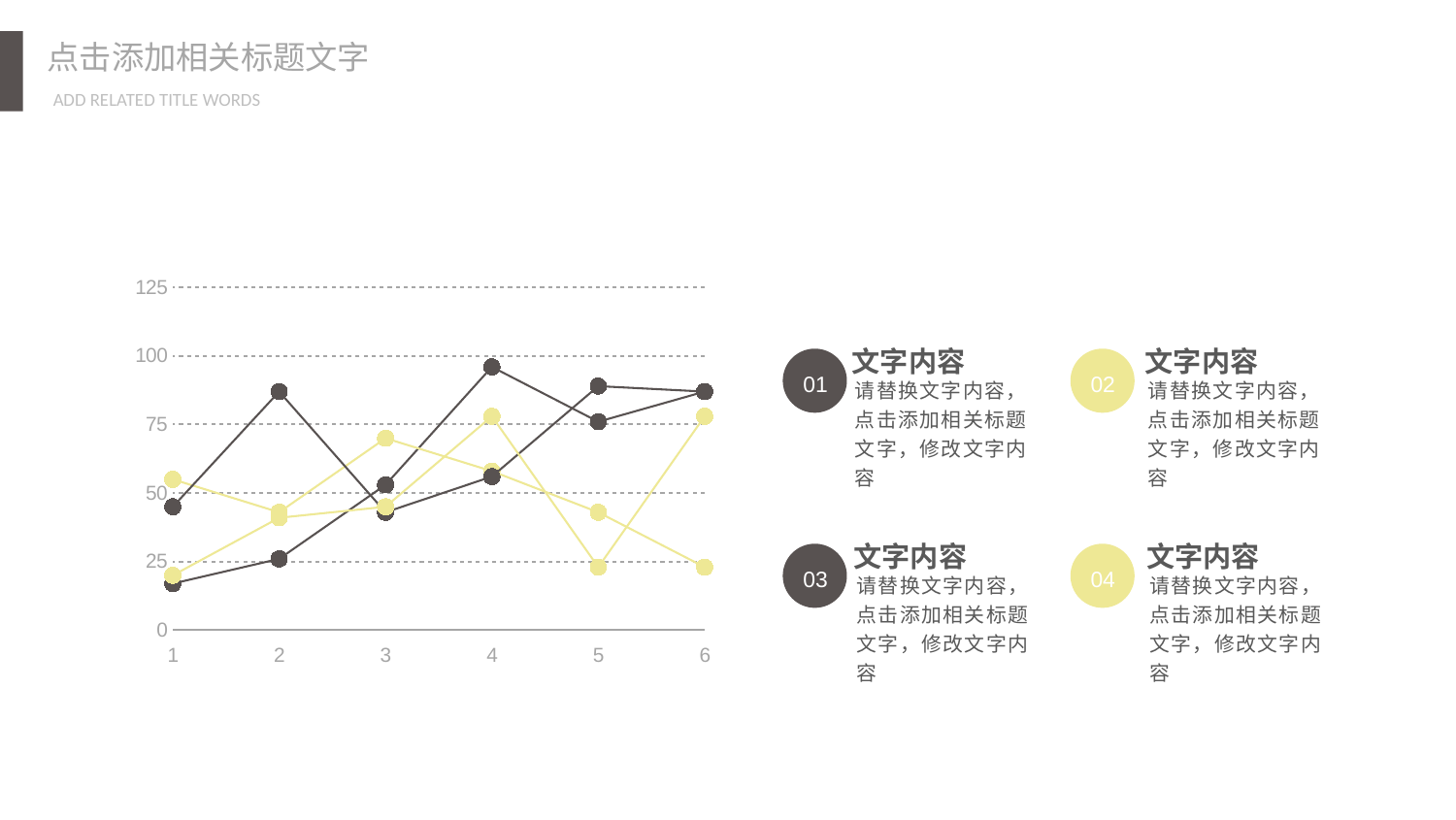
How many lines are plotted on the chart? 4 What kind of chart is shown on the slide? line chart Is the lowest point at x = 3 greater or less than 50? less Is the highest point at x = 2 greater or less than 75? greater At which x-axis value does the chart reach its highest point? 4 Is the lowest point at x = 6 greater or less than 50? less How many points are labelled along the x axis of the chart? 6 What is the highest value shown on the y axis of the chart? 125 What two colours are used for the lines on the chart? dark grey and yellow